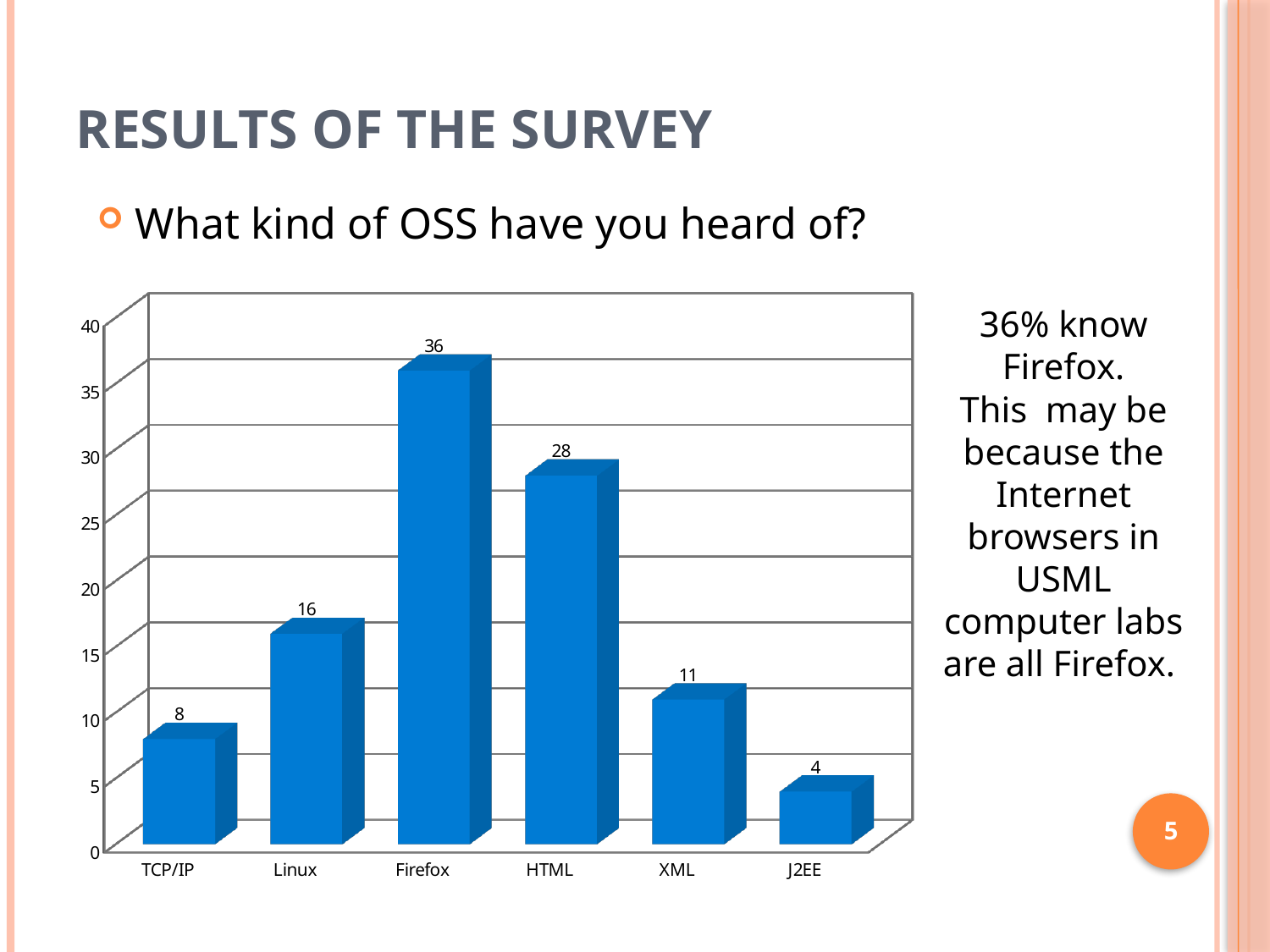
Which category has the highest value? Firefox What is the difference between the values for Firefox and HTML? 8 Which category has the lowest value? J2EE What is the value for Firefox? 36 What kind of chart is shown on the slide? bar chart Is the value for HTML greater or less than 25? greater What is the difference between the values for Linux and XML? 5 What is the value for J2EE? 4 What is the value for TCP/IP? 8 How many categories are shown on the x axis? 6 What colour are the bars in the chart? blue Which is larger, the value for Linux or the value for XML? Linux